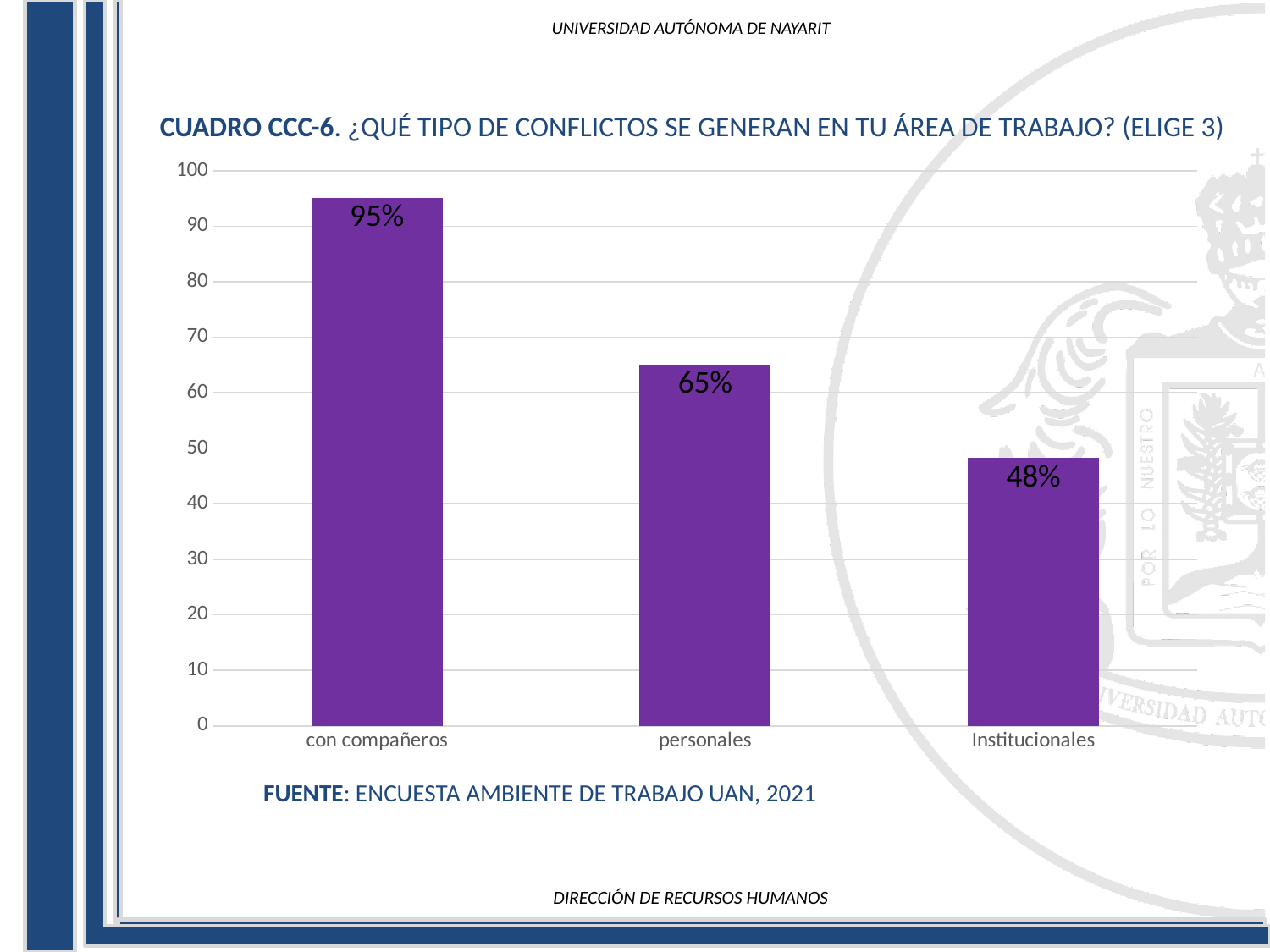
What kind of chart is shown on the slide? bar chart Do the values rise or fall from left to right along the x axis? fall How many categories are shown in the chart? 3 What is the value for Institucionales? 48% What is the value for personales? 65% What is the value for con compañeros? 95% Which is larger, the value for personales or the value for Institucionales? personales What is the difference between the values for personales and Institucionales? 17% What is the difference between the values for con compañeros and personales? 30% Is the value for Institucionales greater or less than 50? less Which category has the highest value? con compañeros Which category has the lowest value? Institucionales